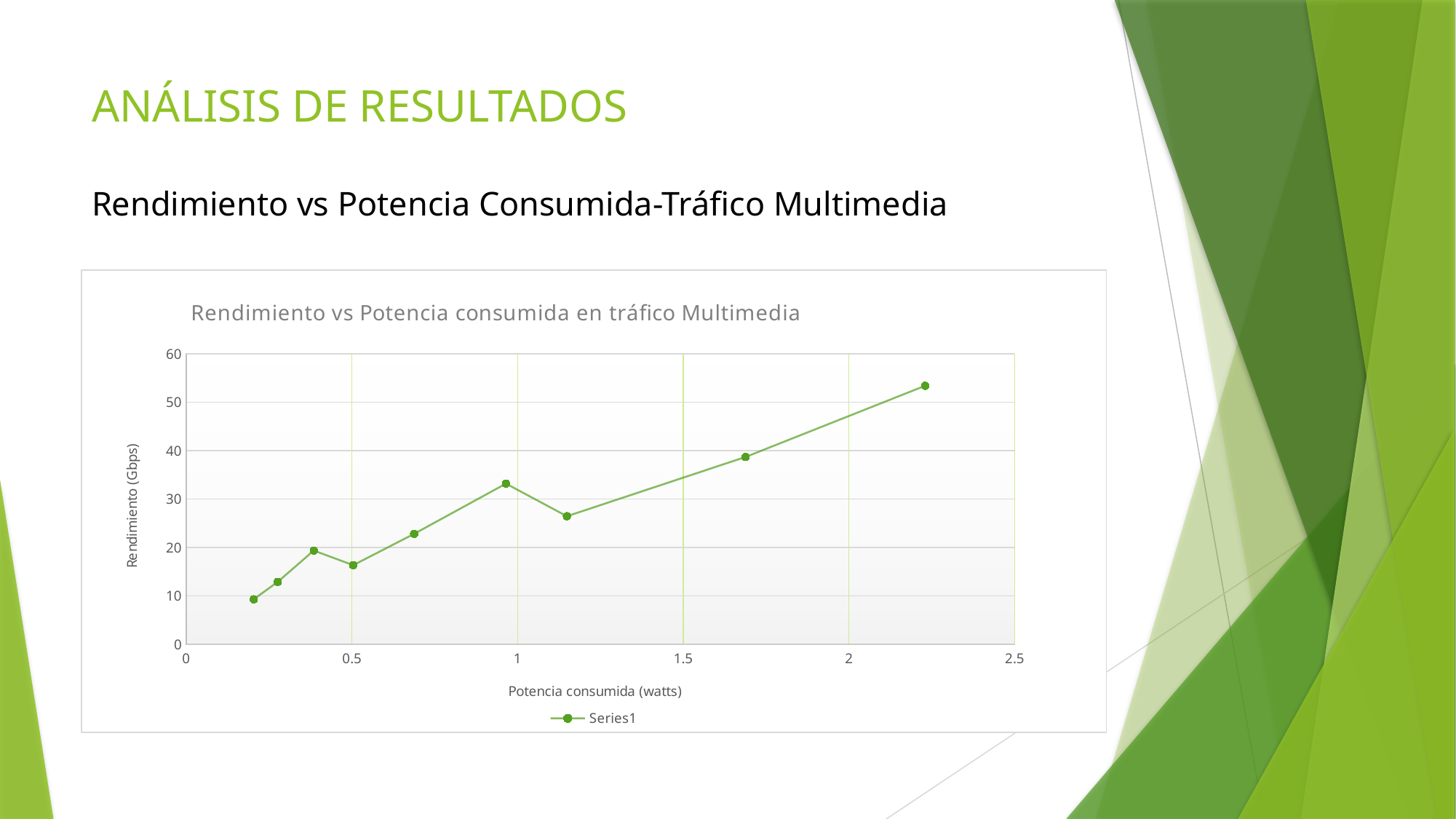
Overall, do the values rise or fall as the x axis (Potencia consumida) increases? rise Is the value of the data point near 1 watt greater or less than 30? greater Is the value of the data point near 1.7 watts greater or less than 40? less What is the label of the y axis? Rendimiento (Gbps) Is the value of the rightmost data point (near 2.25 watts) greater or less than 50? greater What is the maximum value shown on the y axis? 60 How many series does the legend list? 1 How many data points are plotted on the chart? 9 Which is larger: the value at about 1 watt or the value at about 1.15 watts? the value at about 1 watt What kind of chart is shown on the slide? line chart What is the title of the chart? Rendimiento vs Potencia consumida en tráfico Multimedia